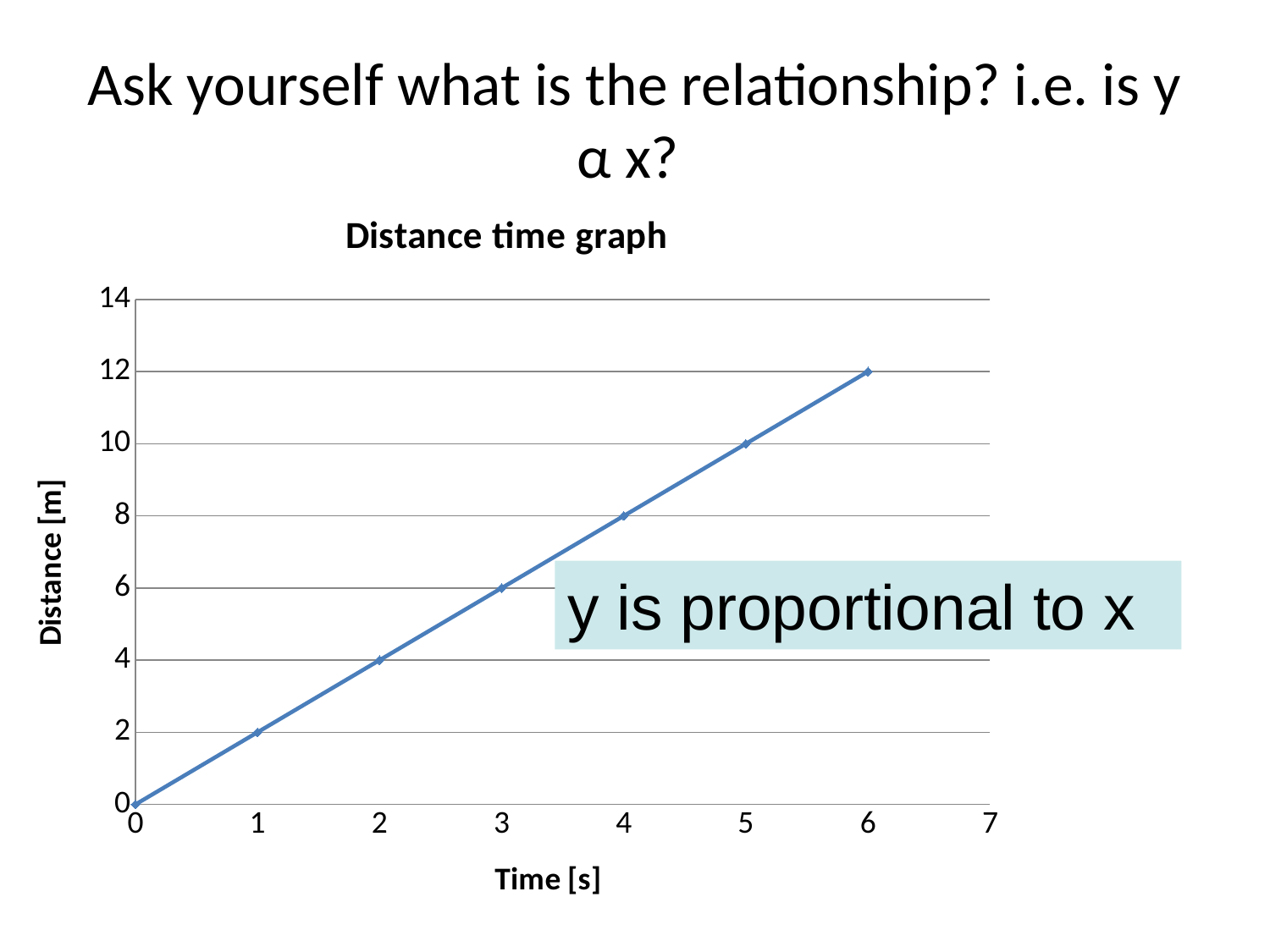
What type of chart is shown on the slide? line chart Does the distance rise or fall as time increases? rise What is the difference in distance between time 5 s and time 2 s? 6 At which time is the distance lowest? 0 At which time is the distance highest? 6 What is the distance at time 6 s? 12 What is the label of the vertical axis? Distance [m] How many data points are plotted on the line? 7 Which has the larger distance, time 4 s or time 2 s? 4 s What is the distance at time 3 s? 6 What is the distance at time 1 s? 2 What is the title of the chart? Distance time graph